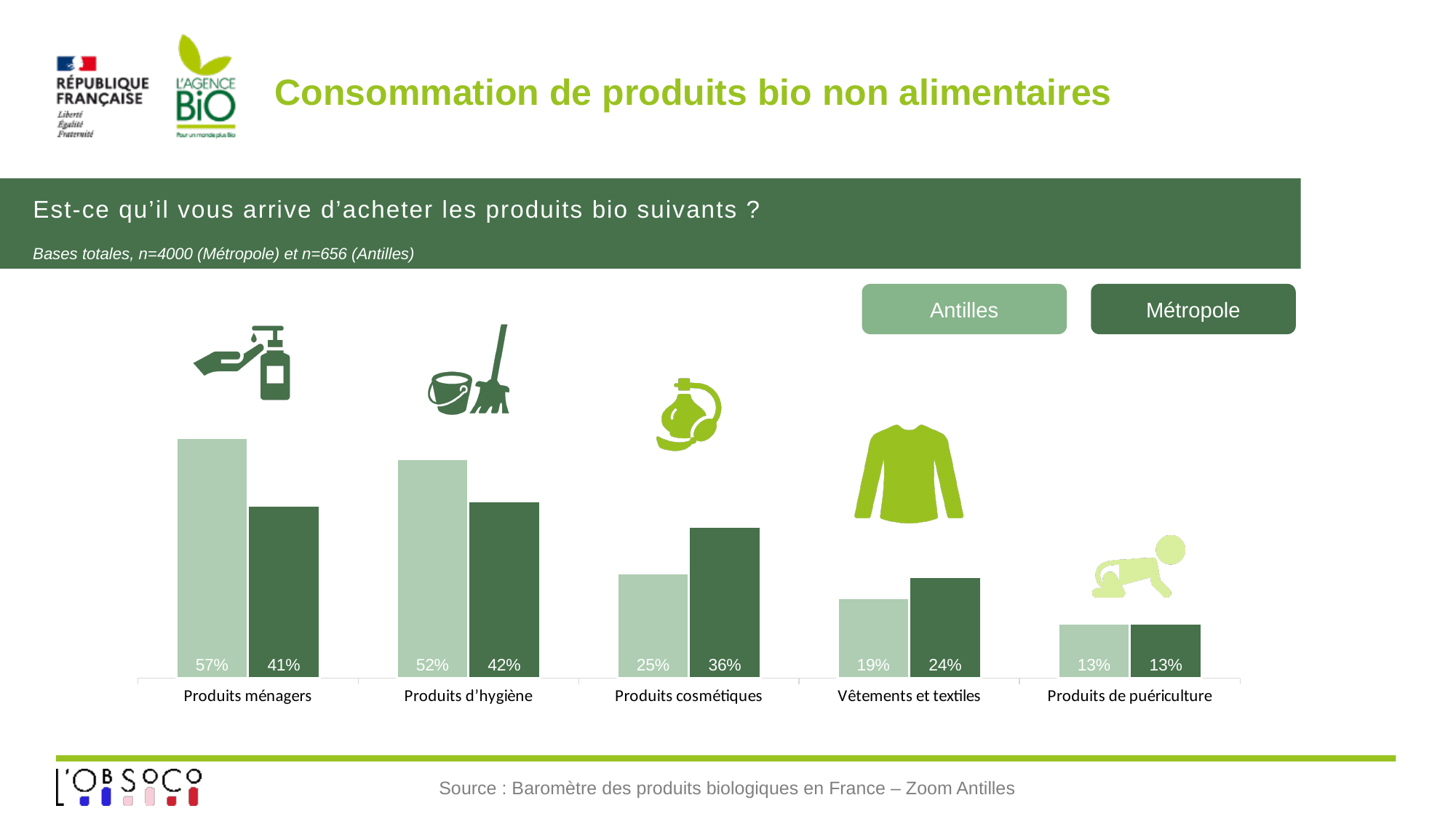
Which category has the lowest Métropole value? Produits de puériculture What is the Antilles value for Vêtements et textiles? 19% What kind of chart is shown on the slide? Bar chart Which category has the highest Antilles value? Produits ménagers How many series does the legend list? 2 Which is larger for Produits d'hygiène, the Antilles value or the Métropole value? Antilles How many product categories are shown on the x axis? 5 What is the difference between the Antilles and Métropole values for Produits ménagers? 16% What is the Métropole value for Produits cosmétiques? 36% Which is larger for Vêtements et textiles, the Antilles value or the Métropole value? Métropole What is the difference between the Métropole and Antilles values for Produits cosmétiques? 11% What is the Antilles value for Produits ménagers? 57%